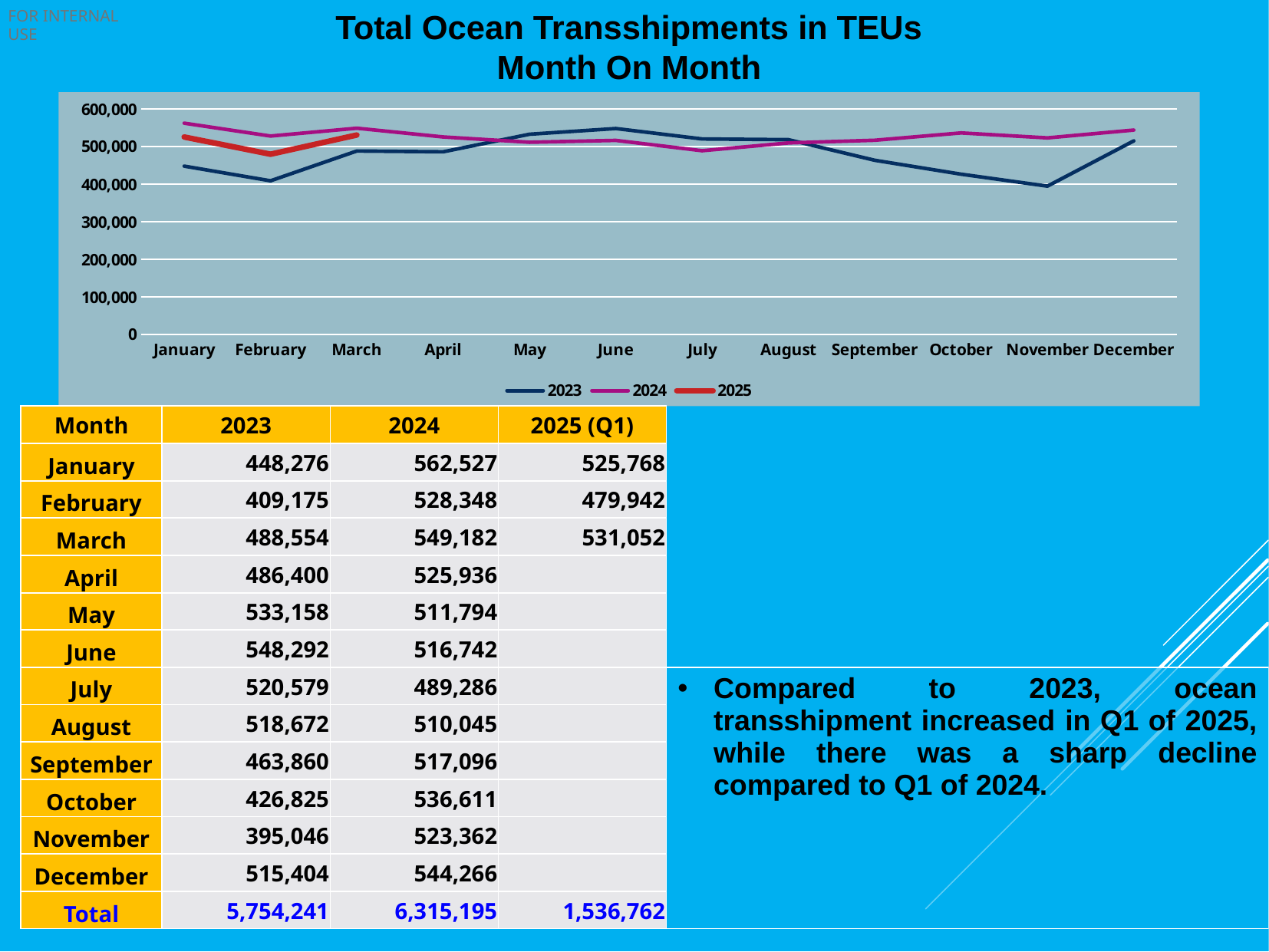
What is the difference between the January 2024 value and the January 2025 value? 36,759 What was the total ocean transshipment in TEUs for January 2023? 448,276 What kind of chart is shown on the slide? line chart Does the 2023 series rise or fall from September to November? fall How many series does the chart legend list? 3 Which series had the larger value in June, 2023 or 2024? 2023 Which month had the highest value for the 2024 series? January How many months are plotted along the x axis of the chart? 12 Which month had the lowest value for the 2024 series? July Is the value for November 2023 greater or less than 400,000? less What was the total ocean transshipment in TEUs for March 2024? 549,182 Which month had the lowest value for the 2023 series? November